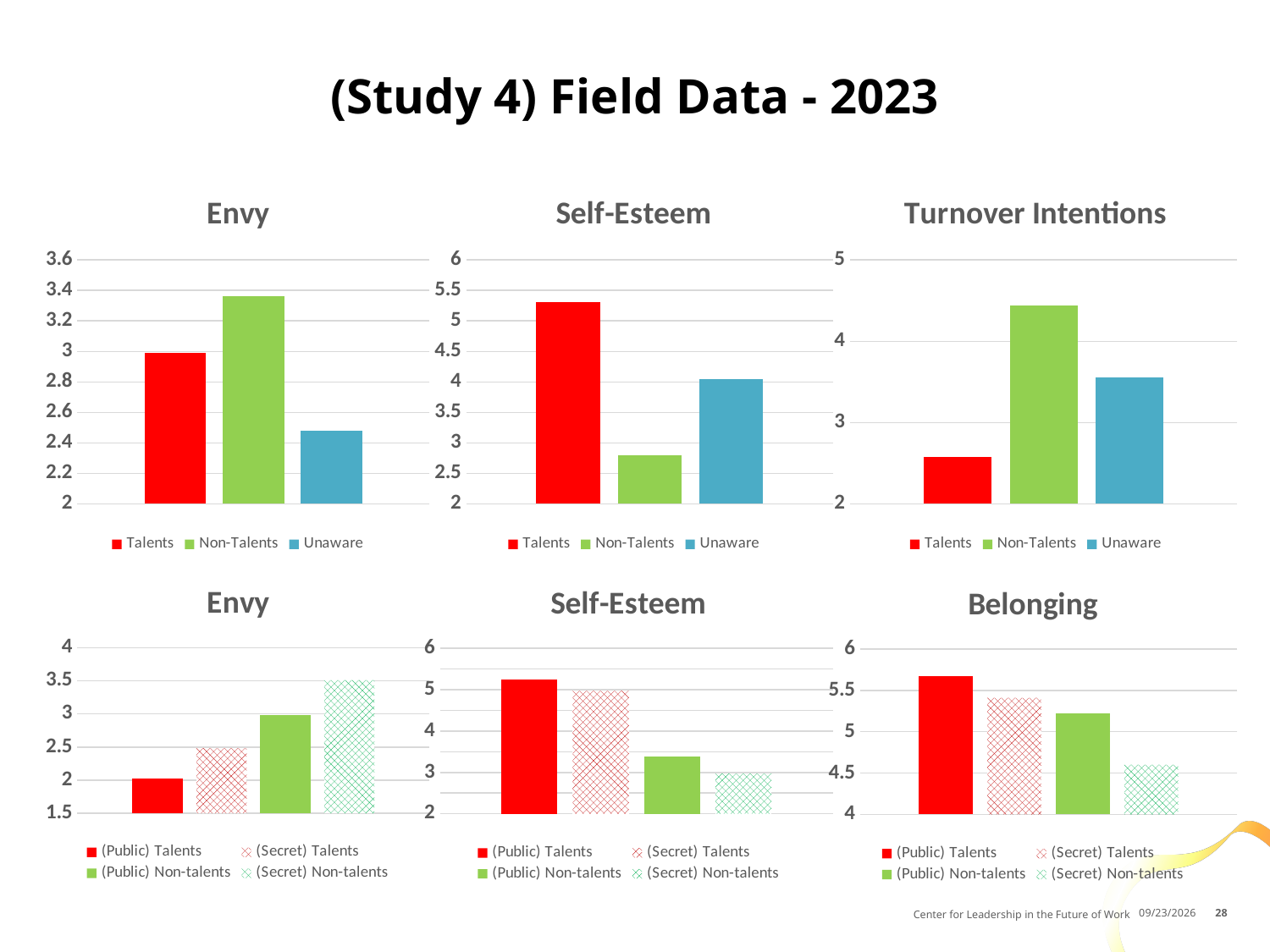
In the Belonging chart, which series has the lowest value? (Secret) Non-talents How many series does the legend of the Belonging chart list? 4 In the top-row Self-Esteem chart, which group has the highest value? Talents In the top-row Envy chart, which group has the lowest value? Unaware In the top-row Self-Esteem chart, is the value for Talents greater or less than 5? greater In the bottom-row Envy chart, which series has the highest value? (Secret) Non-talents In the bottom-row Self-Esteem chart, is the value for (Secret) Non-talents greater or less than 4? less In the top-row Envy chart, which group has the highest value? Non-Talents What kind of chart is the Turnover Intentions chart? Bar chart In the Turnover Intentions chart, which is larger, the value for Unaware or the value for Talents? Unaware In the Turnover Intentions chart, is the value for Non-Talents greater or less than 4? greater In the Turnover Intentions chart, which group has the lowest value? Talents